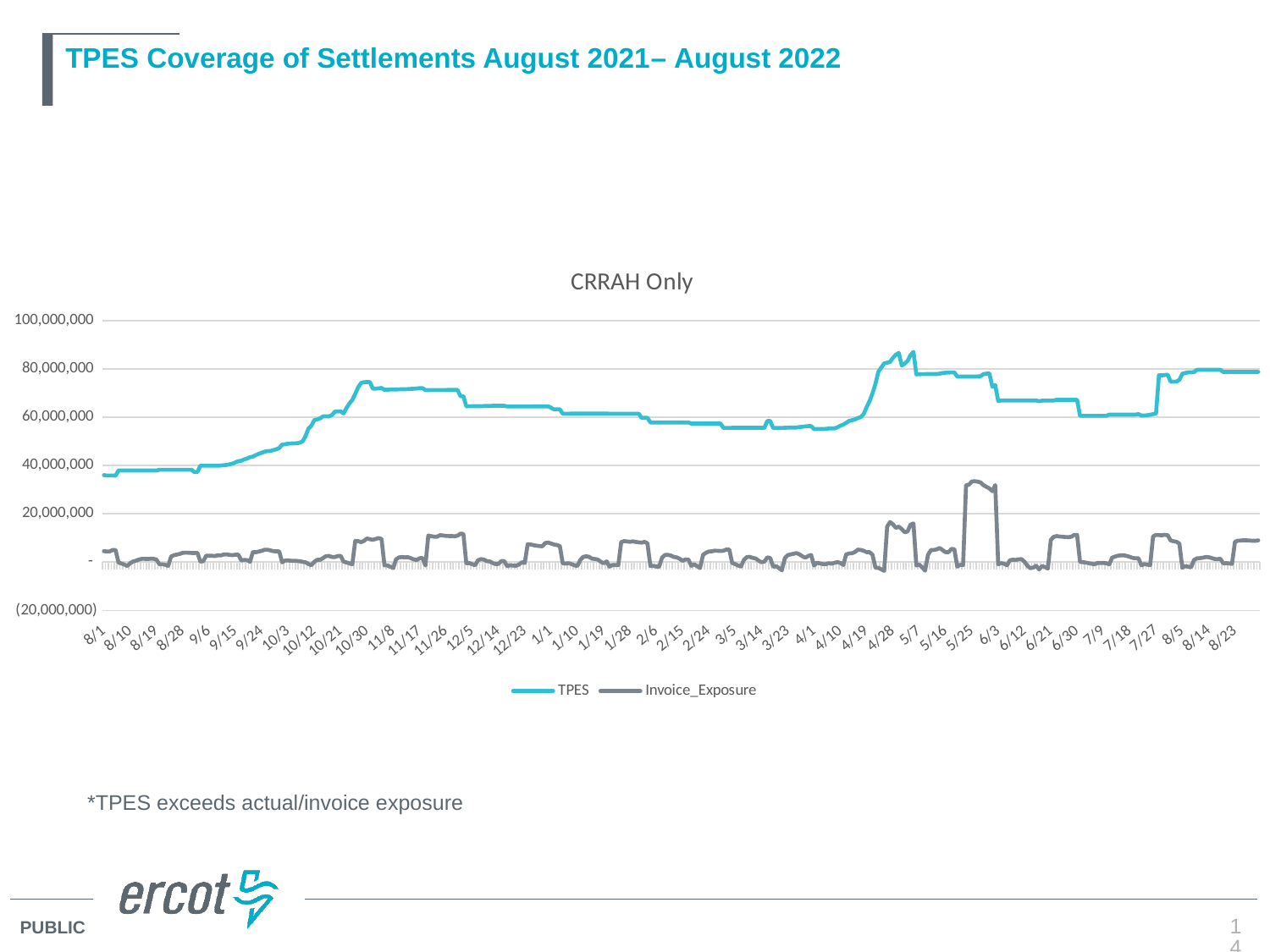
Is the TPES value at 10/30 greater or less than 60,000,000? greater What kind of chart is shown on the slide? Line chart At 5/25, which series has the larger value, TPES or Invoice_Exposure? TPES What is the title shown above the chart? CRRAH Only Is the Invoice_Exposure value at 5/25 greater or less than 20,000,000? greater Is the TPES value at 3/14 greater or less than 60,000,000? less Does the TPES line rise or fall between 8/1 and 10/30? Rise How many series does the chart legend list? 2 What are the two series named in the chart legend? TPES and Invoice_Exposure Which series reaches the highest value on the chart? TPES